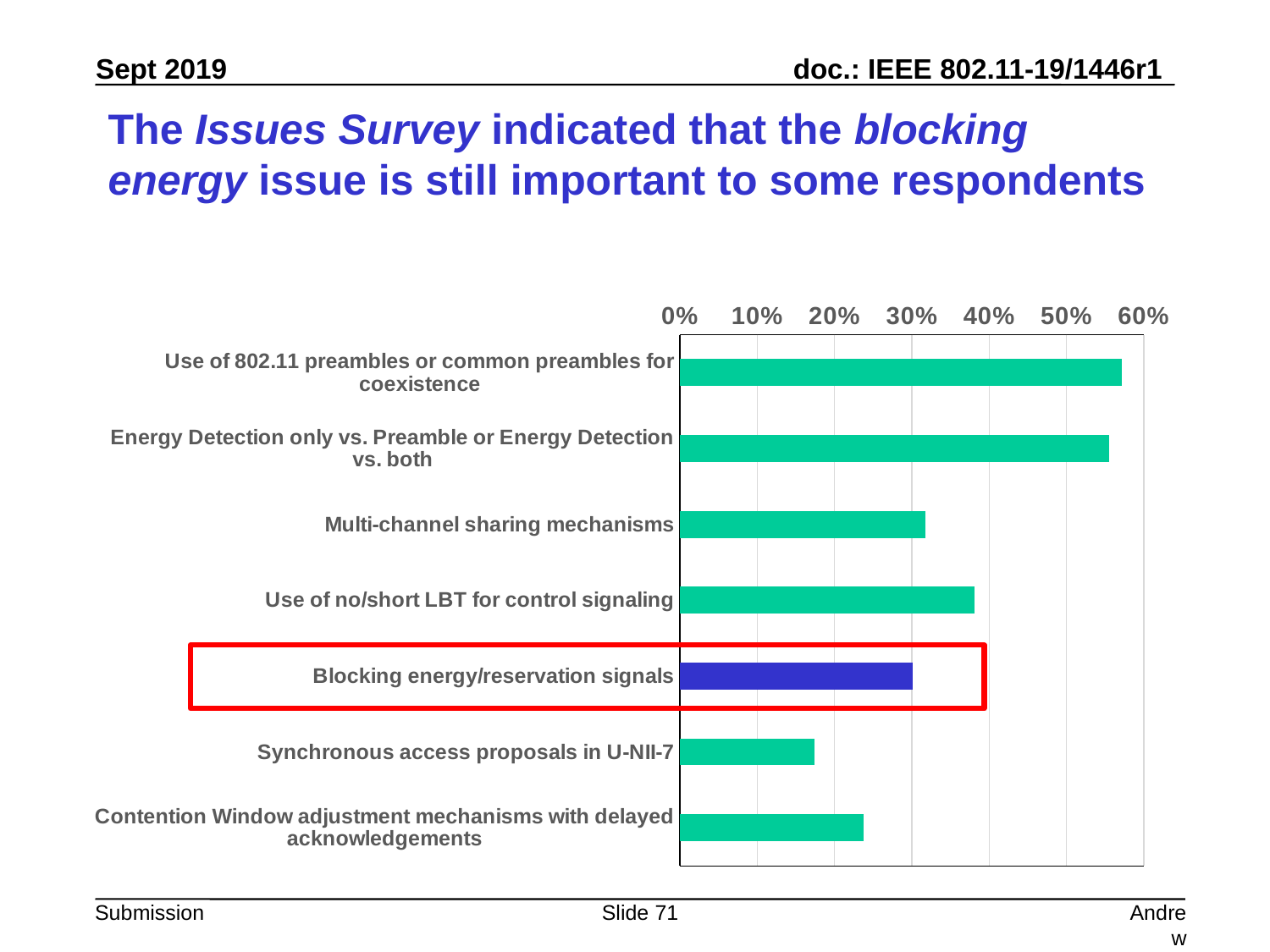
Which has the larger value: Use of no/short LBT for control signaling or Multi-channel sharing mechanisms? Use of no/short LBT for control signaling Is the value for Use of 802.11 preambles or common preambles for coexistence greater or less than 50%? greater How many categories (bars) does the chart show? 7 Is the value for Energy Detection only vs. Preamble or Energy Detection vs. both greater or less than 50%? greater What kind of chart is shown on the slide? bar chart What is the highest value shown on the chart's percentage axis? 60% Is the value for Synchronous access proposals in U-NII-7 greater or less than 20%? less Which category's bar is shown in a different colour (blue) and outlined with a red box? Blocking energy/reservation signals Which category has the lowest value in the chart? Synchronous access proposals in U-NII-7 Which has the larger value: Contention Window adjustment mechanisms with delayed acknowledgements or Synchronous access proposals in U-NII-7? Contention Window adjustment mechanisms with delayed acknowledgements